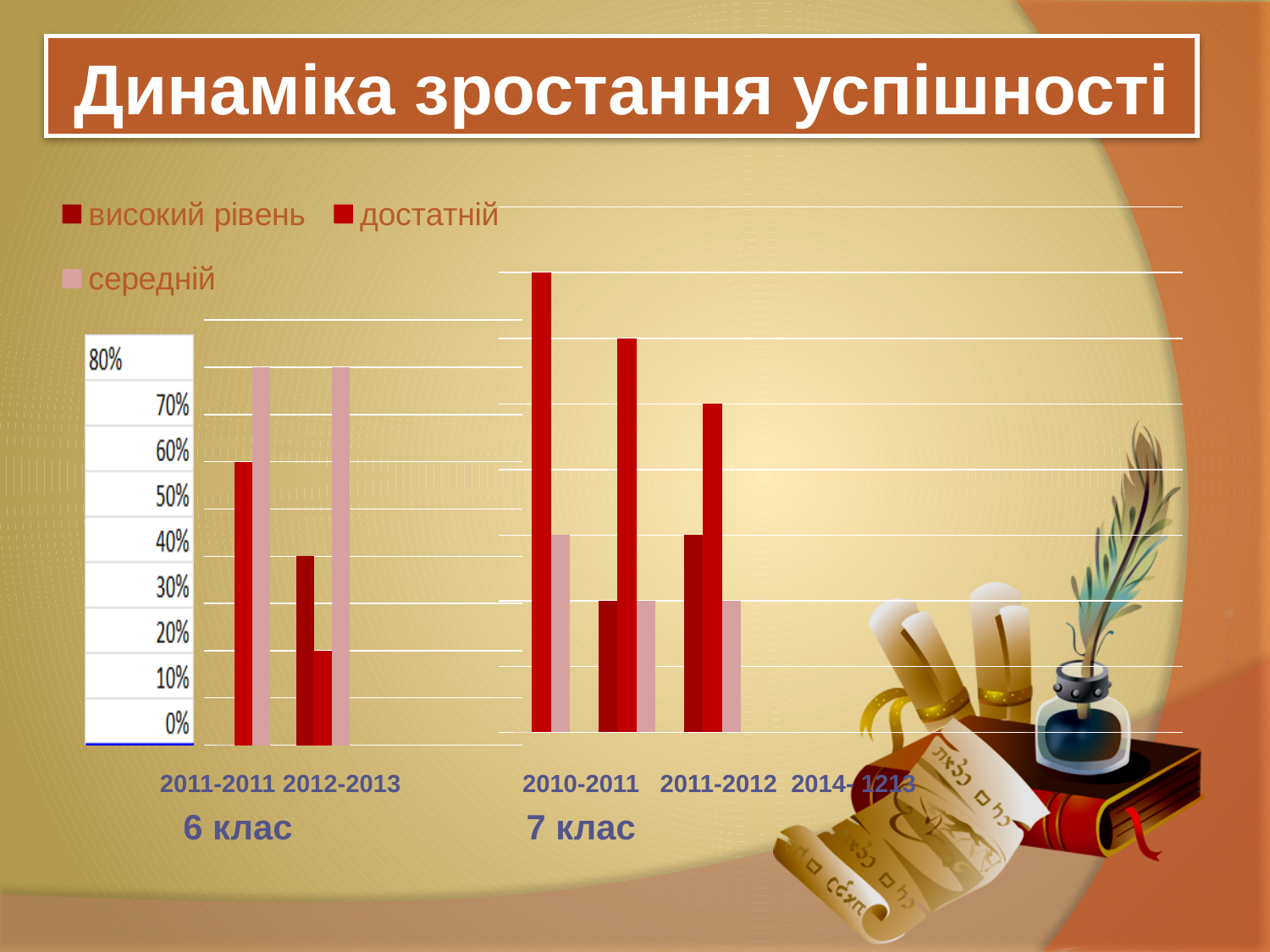
What is the title of the slide's chart area? Динаміка зростання успішності How many series does the legend list? 3 What kind of chart is shown for 6 клас on the left of the slide? bar chart In the 6 клас chart on the left, is the value of високий рівень for 2012-2013 greater or less than 30%? greater In the 6 клас chart on the left, which category has the larger високий рівень value, 2011-2011 or 2012-2013? 2012-2013 In the 6 клас chart on the left, is the value of високий рівень for 2011-2011 greater or less than 50%? less In the 7 клас chart on the right, how many categories are shown on the x axis? 3 In the 6 клас chart on the left, how many categories are shown on the x axis? 2 In the 6 клас chart on the left, is the value of достатній for 2012-2013 greater or less than 30%? less